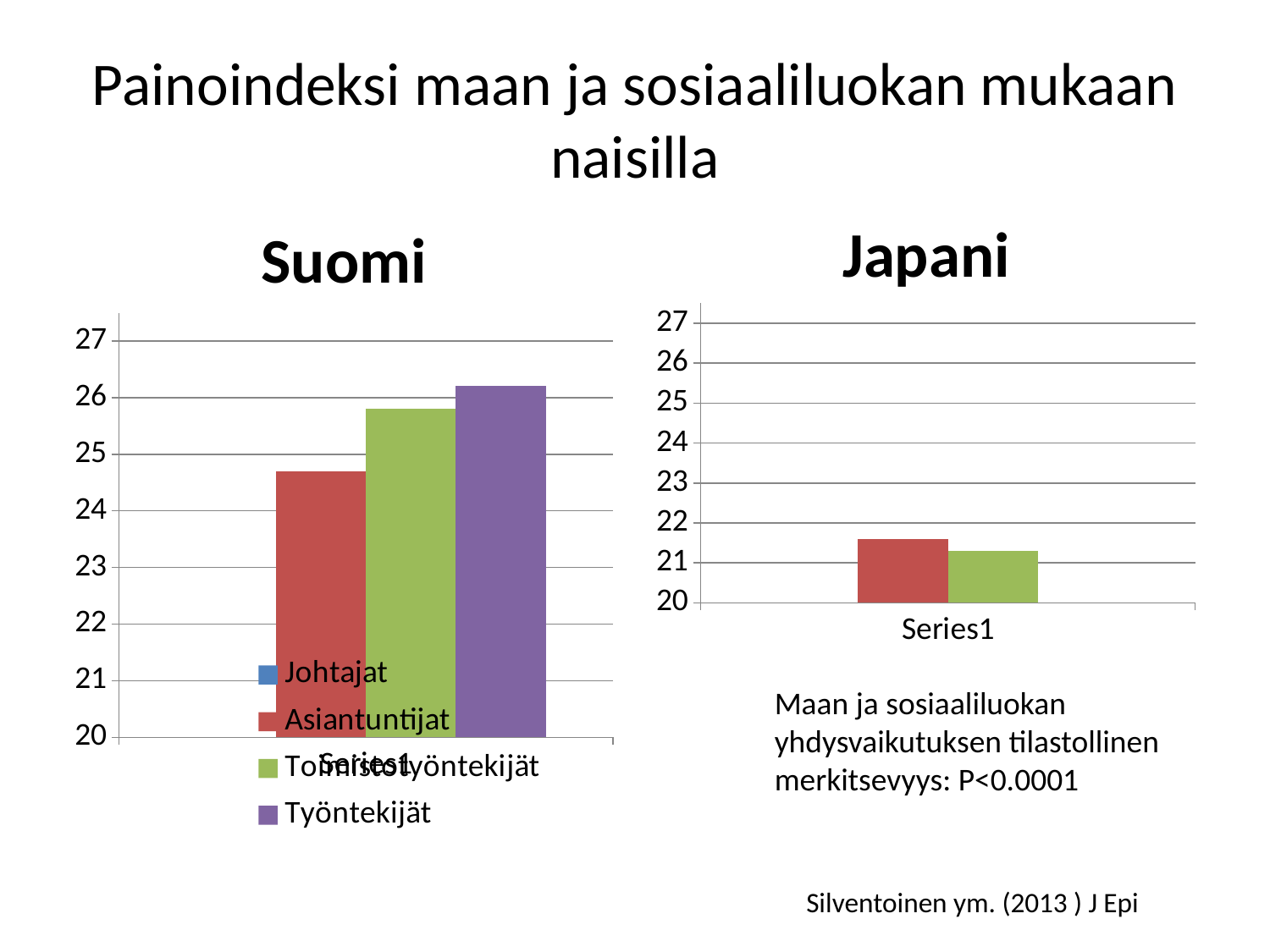
In the Suomi chart, which is larger, the bar for Asiantuntijat or the bar for Toimistotyöntekijät? Toimistotyöntekijät In the Suomi chart, is the value for Asiantuntijat greater or less than 25? less How many bars are plotted in the Japani chart? 2 What kind of chart is the Suomi chart? bar chart In the Japani chart, is the value of the red bar greater or less than 22? less In the Suomi chart, which series has the highest bar? Työntekijät In the Suomi chart, is the value for Työntekijät greater or less than 26? greater In the Japani chart, which is larger, the red bar or the green bar? the red bar In the Suomi chart legend, what colour is assigned to Johtajat? blue How many series does the legend of the Suomi chart list? 4 What kind of chart is the Japani chart? bar chart